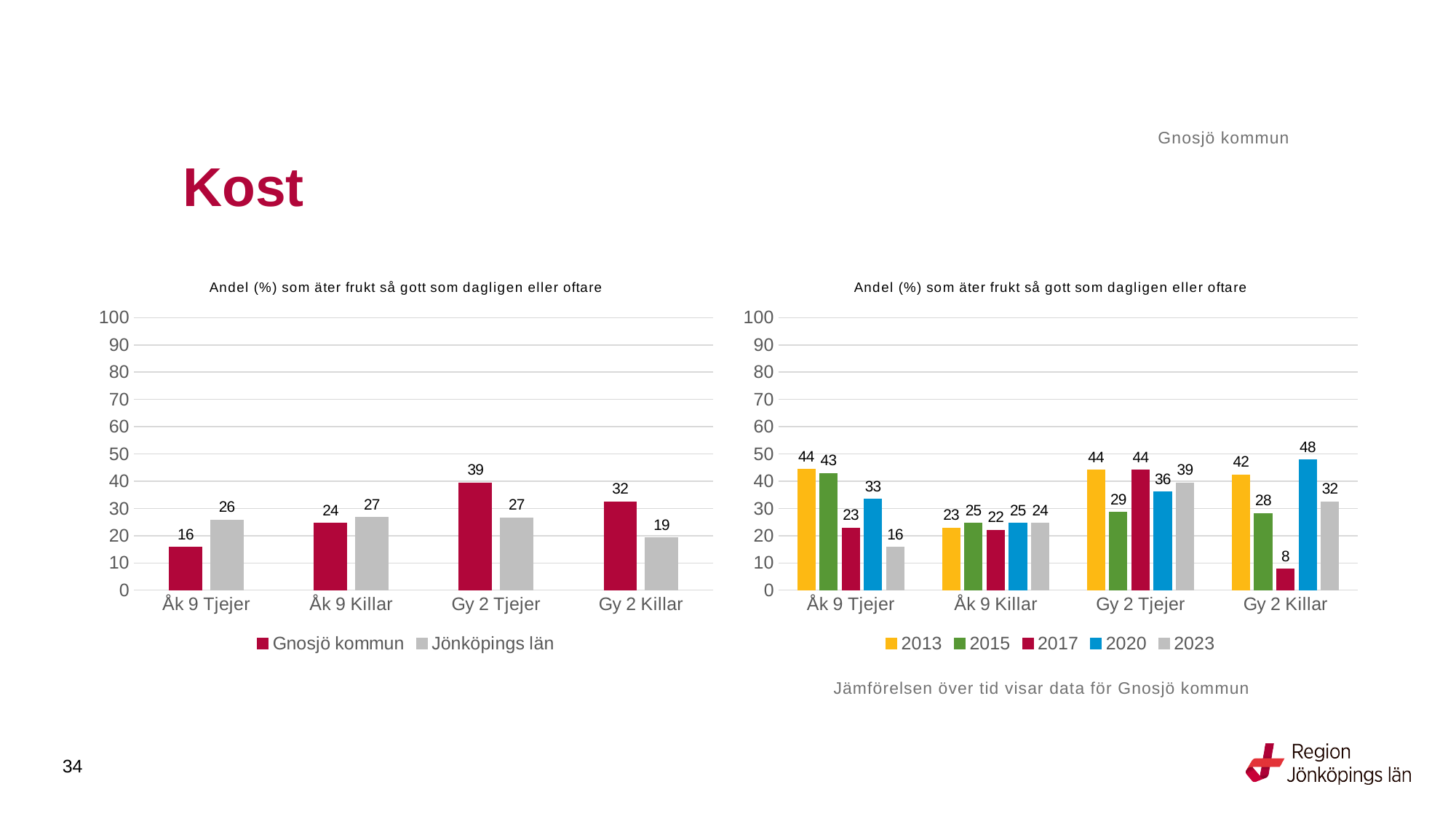
In the right chart, what is the value for 2020 for Gy 2 Killar? 48 In the right chart, what is the value for 2017 for Gy 2 Killar? 8 In the left chart, what is the value for Gnosjö kommun for Gy 2 Tjejer? 39 In the left chart, which is larger for Gy 2 Killar: Gnosjö kommun or Jönköpings län? Gnosjö kommun How many series does the legend of the right chart list? 5 In the left chart, which category has the lowest value for Gnosjö kommun? Åk 9 Tjejer In the left chart, what is the value for Jönköpings län for Gy 2 Killar? 19 What kind of chart is the right chart? Bar chart How many series does the legend of the left chart list? 2 In the right chart, what is the difference between 2013 and 2023 for Åk 9 Tjejer? 28 In the right chart, which year has the highest value for Gy 2 Killar? 2020 In the left chart, what is the difference between Gnosjö kommun and Jönköpings län for Åk 9 Tjejer? 10